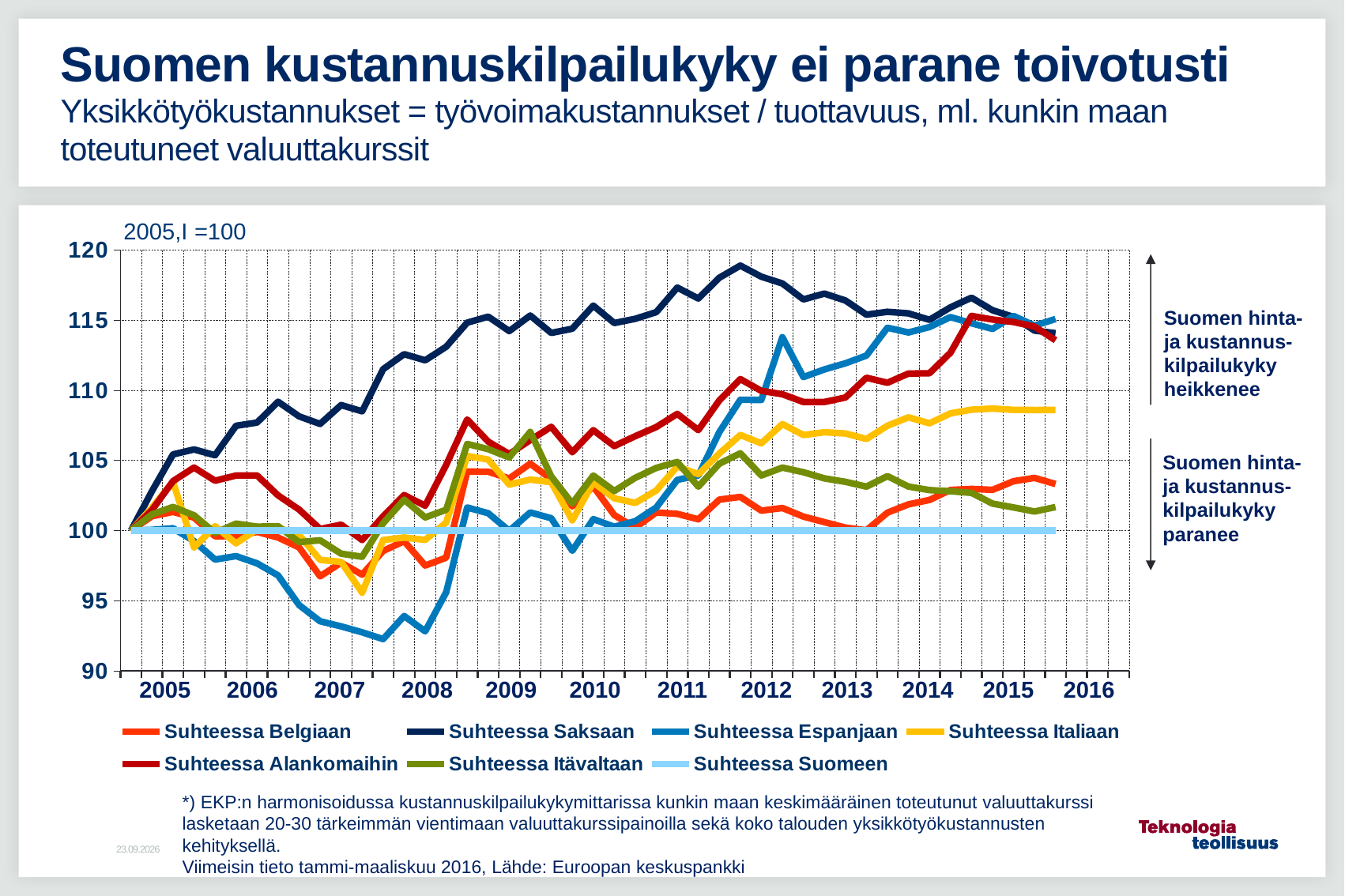
How many series does the legend list? 7 Which series reaches the lowest value anywhere on the chart? Suhteessa Espanjaan Is the value for Suhteessa Saksaan at the end of 2011 greater or less than 115? greater Does the Suhteessa Saksaan series rise or fall between 2005 and 2008? rise Does the Suhteessa Espanjaan series rise or fall between 2005 and 2007? fall Is the value for Suhteessa Espanjaan in 2007 greater or less than 95? less At the end of 2015, which is larger: Suhteessa Italiaan or Suhteessa Belgiaan? Suhteessa Italiaan Is the value for Suhteessa Italiaan at the end of 2015 greater or less than 105? greater What base period and value is the index set to, as written above the chart? 2005,I =100 What kind of chart is shown on the slide? line chart Which series reaches the highest value anywhere on the chart? Suhteessa Saksaan